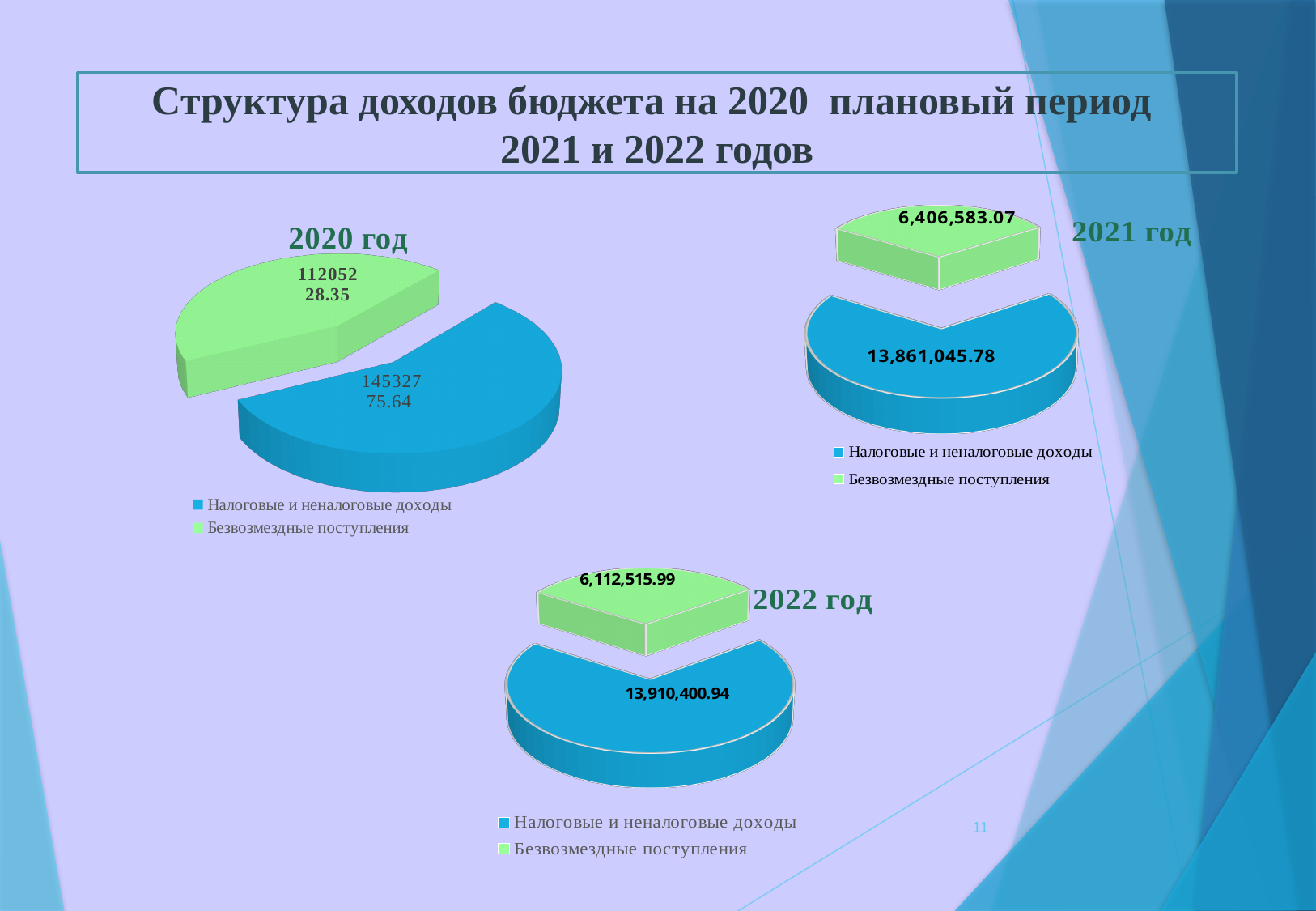
In the 2022 год chart, which category has the smallest slice? Безвозмездные поступления How many charts are shown on the slide? 3 In the 2022 год chart, which is larger: Налоговые и неналоговые доходы or Безвозмездные поступления? Налоговые и неналоговые доходы What type of chart is the 2021 год chart? Pie chart In the 2022 год chart, what is the value for Безвозмездные поступления? 6,112,515.99 In the 2021 год chart, what is the difference between Налоговые и неналоговые доходы and Безвозмездные поступления? 7,454,462.71 In the 2021 год chart, what is the value for Налоговые и неналоговые доходы? 13,861,045.78 In the 2021 год chart, which category has the largest slice? Налоговые и неналоговые доходы How many slices does the 2022 год chart have? 2